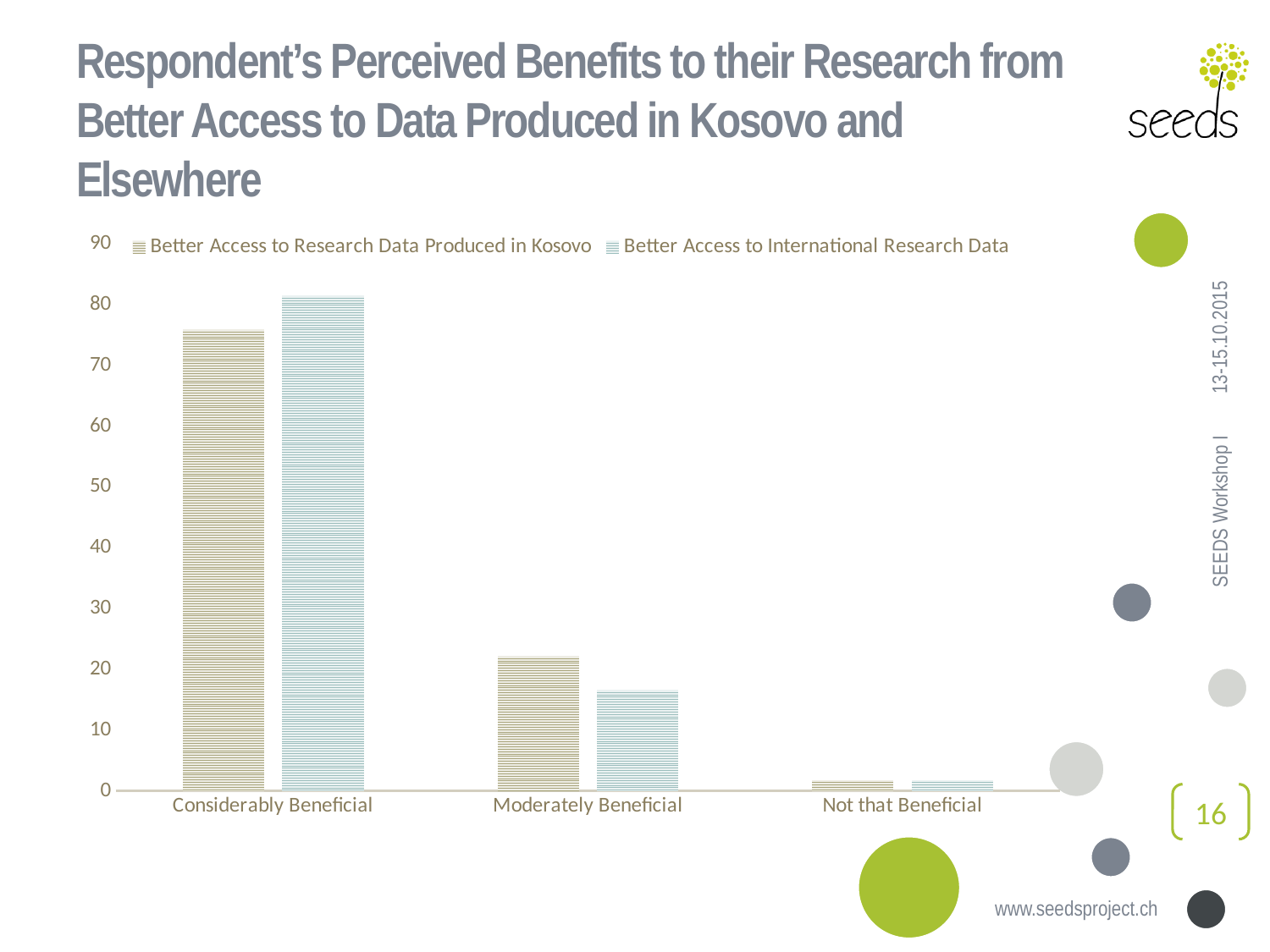
Which category has the lowest value for Better Access to Research Data Produced in Kosovo? Not that Beneficial For Moderately Beneficial, which series has the larger value: Better Access to Research Data Produced in Kosovo or Better Access to International Research Data? Better Access to Research Data Produced in Kosovo Is the value for Better Access to Research Data Produced in Kosovo at Considerably Beneficial greater or less than 80? less Do the values for Better Access to International Research Data rise or fall from Considerably Beneficial to Not that Beneficial? fall How many series does the legend list? 2 What kind of chart is shown on the slide? bar chart For Considerably Beneficial, which series has the larger value: Better Access to Research Data Produced in Kosovo or Better Access to International Research Data? Better Access to International Research Data Is the value for Better Access to International Research Data at Considerably Beneficial greater or less than 80? greater What is the first series named in the legend? Better Access to Research Data Produced in Kosovo Is the value for Better Access to Research Data Produced in Kosovo at Moderately Beneficial greater or less than 20? greater Which category has the highest value for Better Access to International Research Data? Considerably Beneficial How many categories are shown on the x axis? 3